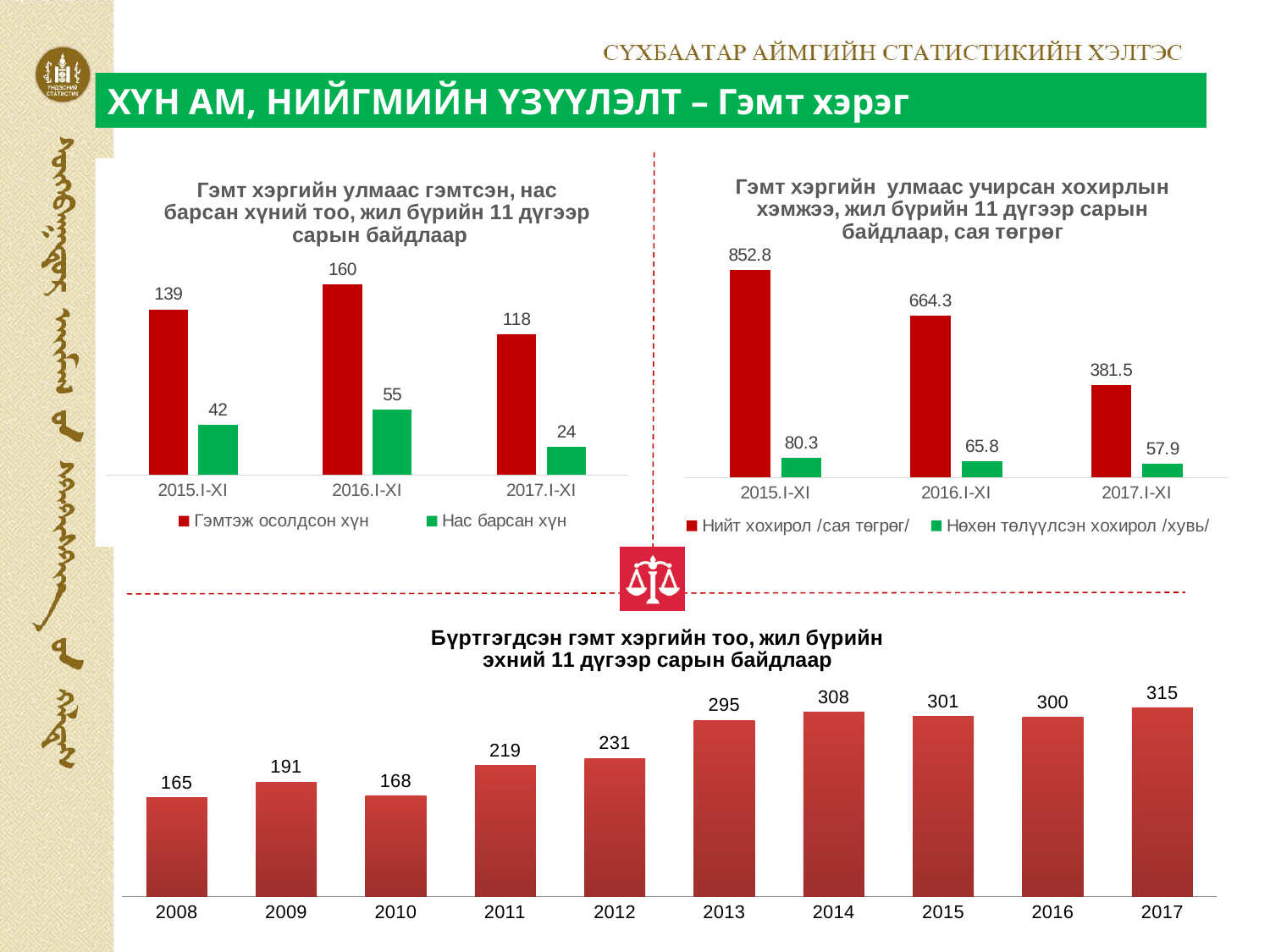
In the top-left chart, how many series does the legend list? 2 In the top-right chart, does 'Нийт хохирол /сая төгрөг/' rise or fall from 2015.I-XI to 2017.I-XI? fall What kind of chart is the bottom chart? bar chart In the top-left chart, what is the difference between 'Гэмтэж осолдсон хүн' and 'Нас барсан хүн' in 2015.I-XI? 97 In the top-right chart, what is the value for 'Нийт хохирол /сая төгрөг/' in 2015.I-XI? 852.8 In the top-right chart, what is the value for 'Нөхөн төлүүлсэн хохирол /хувь/' in 2016.I-XI? 65.8 In the top-right chart, in which period is 'Нийт хохирол /сая төгрөг/' lowest? 2017.I-XI In the bottom chart, how many years are shown on the x axis? 10 In the bottom chart, which year has the highest value? 2017 In the top-left chart, what is the value for 'Нас барсан хүн' in 2017.I-XI? 24 In the bottom chart, what is the value for 2013? 295 In the top-left chart, what is the value for 'Гэмтэж осолдсон хүн' in 2016.I-XI? 160